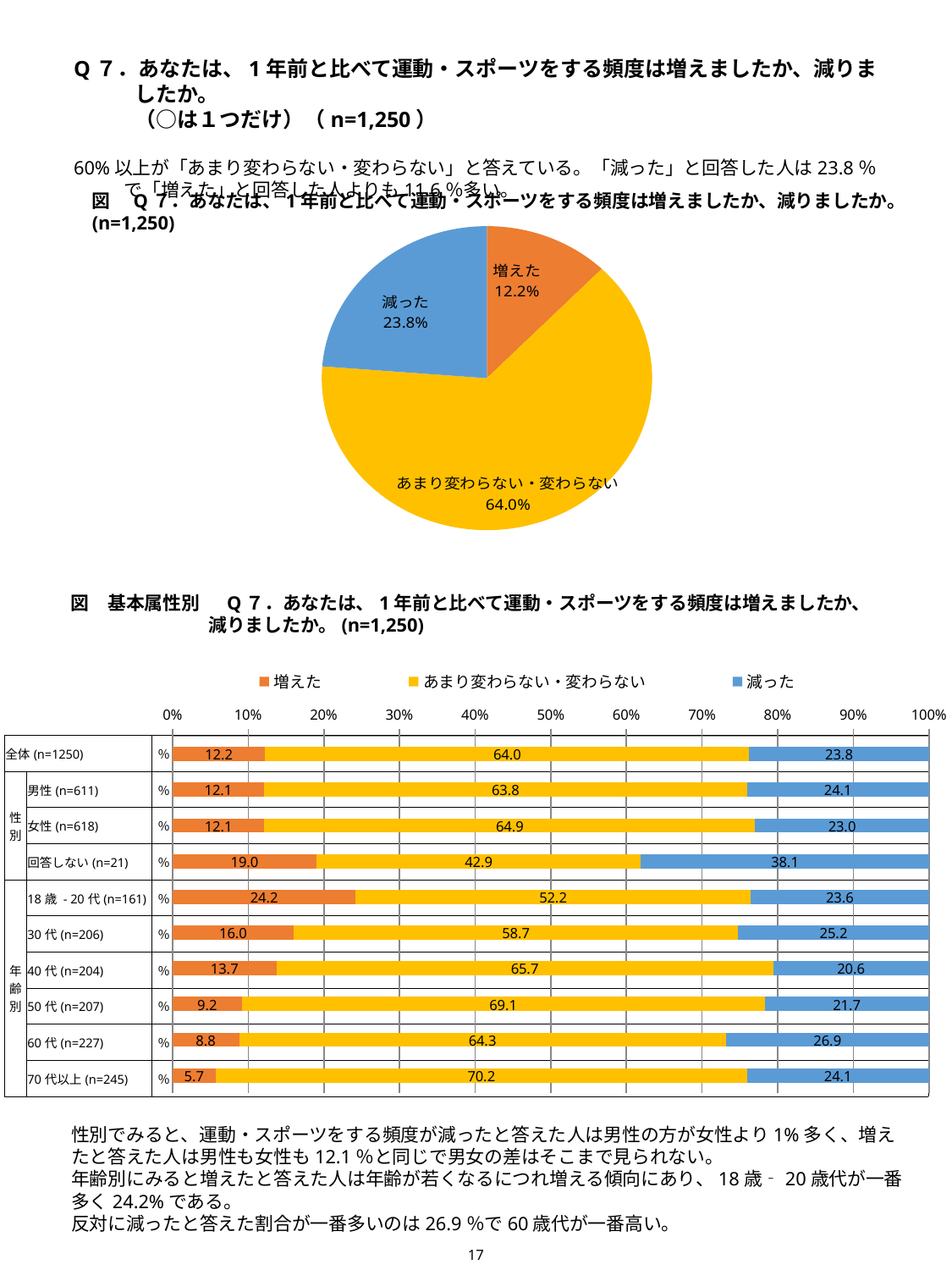
In the top pie chart, which category has the largest share? あまり変わらない・変わらない In the bottom bar chart, what is the value of 「あまり変わらない・変わらない」 for 回答しない (n=21)? 42.9 In the bottom bar chart, which is larger: the 「減った」 value for 男性 (n=611) or for 女性 (n=618)? 男性 (n=611) In the bottom bar chart, what is the value of 「増えた」 for 18歳‐20代 (n=161)? 24.2 In the top pie chart, what share of respondents answered 「減った」? 23.8% In the bottom bar chart, which age group has the highest value for 「減った」? 60代 (n=227) How many series does the legend of the bottom bar chart list? 3 What kind of chart is the bottom chart on the slide? bar chart What kind of chart is the top chart on the slide? pie chart In the bottom bar chart, which age group has the lowest value for 「増えた」? 70代以上 (n=245) In the top pie chart, what is the difference between the share for 「減った」 and the share for 「増えた」? 11.6% In the top pie chart, which category has the smallest share? 増えた